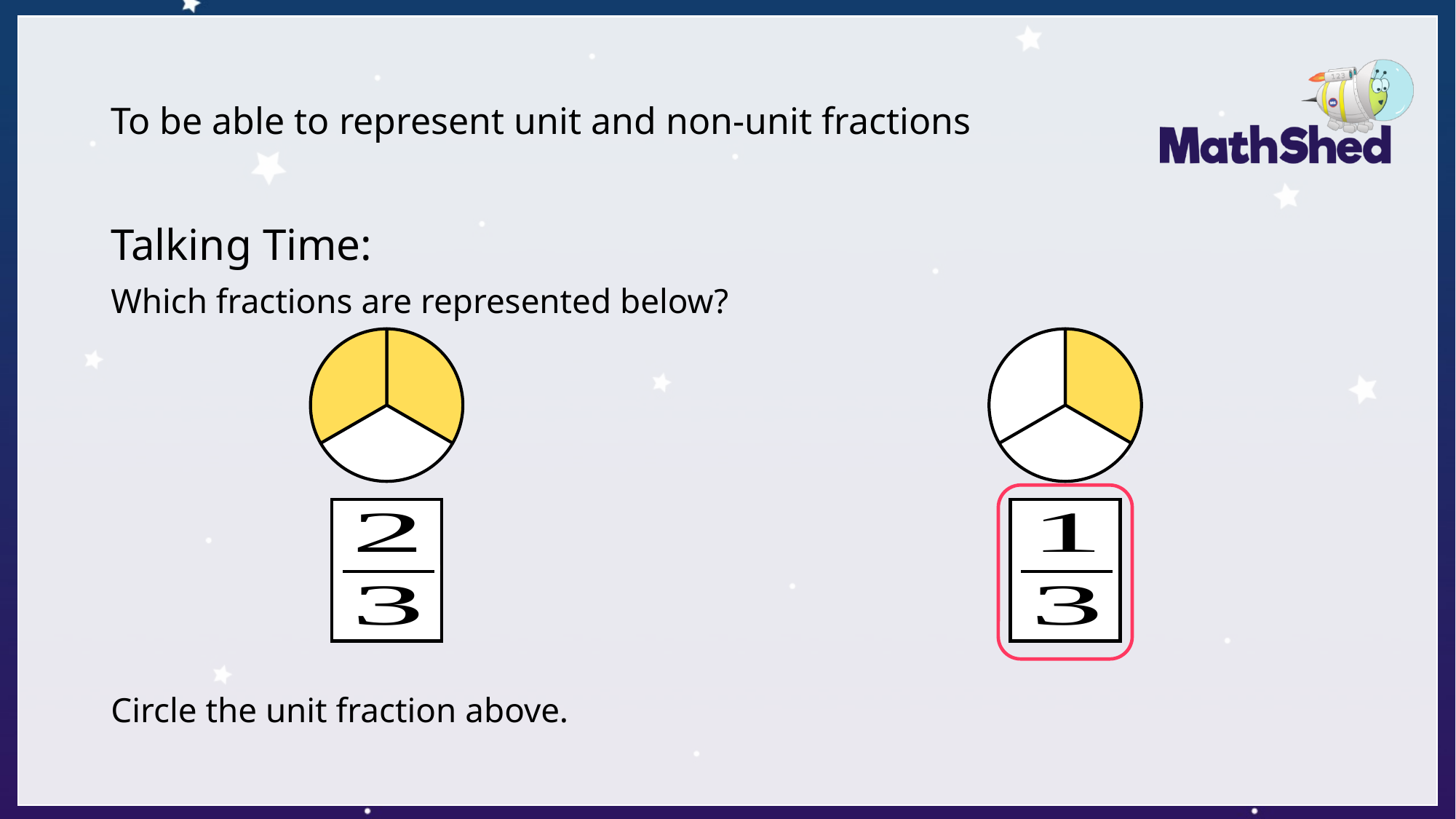
Which fraction on the slide is circled in pink? 1/3 How many sections of the right circle are shaded yellow? 1 Which circle has the larger shaded share, the left or the right? left What fraction is printed below the left circle? 2/3 What is the difference between the shaded shares of the left and right circles? 1/3 How many equal parts is the right circle divided into? 3 What share of the left circle is shaded yellow? 2/3 What kind of chart is used to represent the fractions on the slide? pie chart How many sections of the left circle are shaded yellow? 2 What share of the right circle is shaded yellow? 1/3 What fraction is printed below the right circle? 1/3